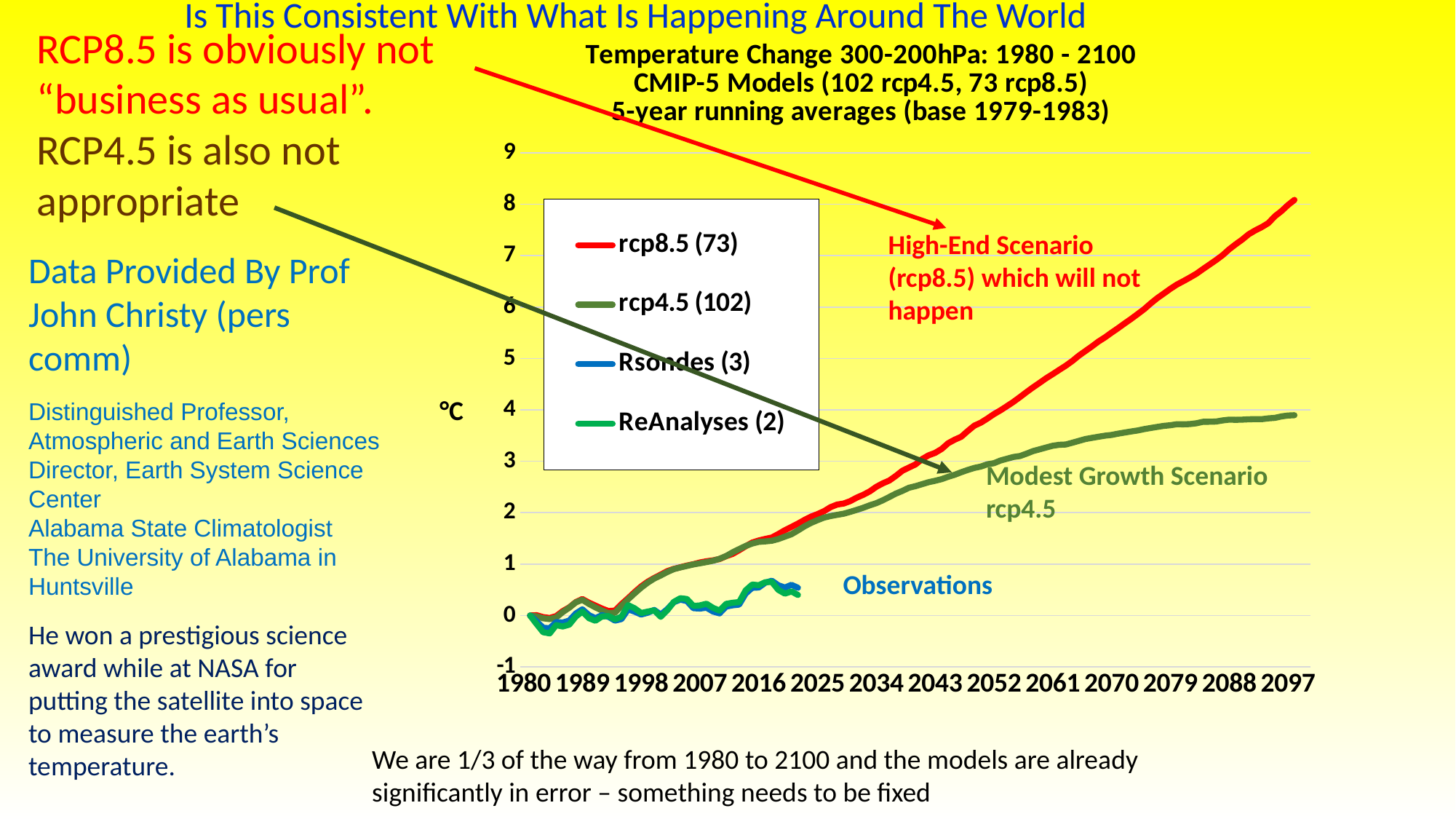
Is the value for rcp8.5 (73) at 2079 greater or less than 6? greater Does the rcp8.5 (73) series rise or fall from 1980 to 2097? rise Is the value for rcp8.5 (73) at 2097 greater or less than 7? greater How many series does the chart legend list? 4 Is the value for rcp4.5 (102) at 2097 greater or less than 3? greater Which series reaches the highest value by 2097? rcp8.5 (73) What is the first line of the chart title? Temperature Change 300-200hPa: 1980 - 2100 What unit is shown as the y-axis label? °C At 2097, which is larger: the rcp8.5 (73) value or the rcp4.5 (102) value? rcp8.5 (73) How many year labels are shown along the x axis? 14 What kind of chart is shown on the slide? line chart